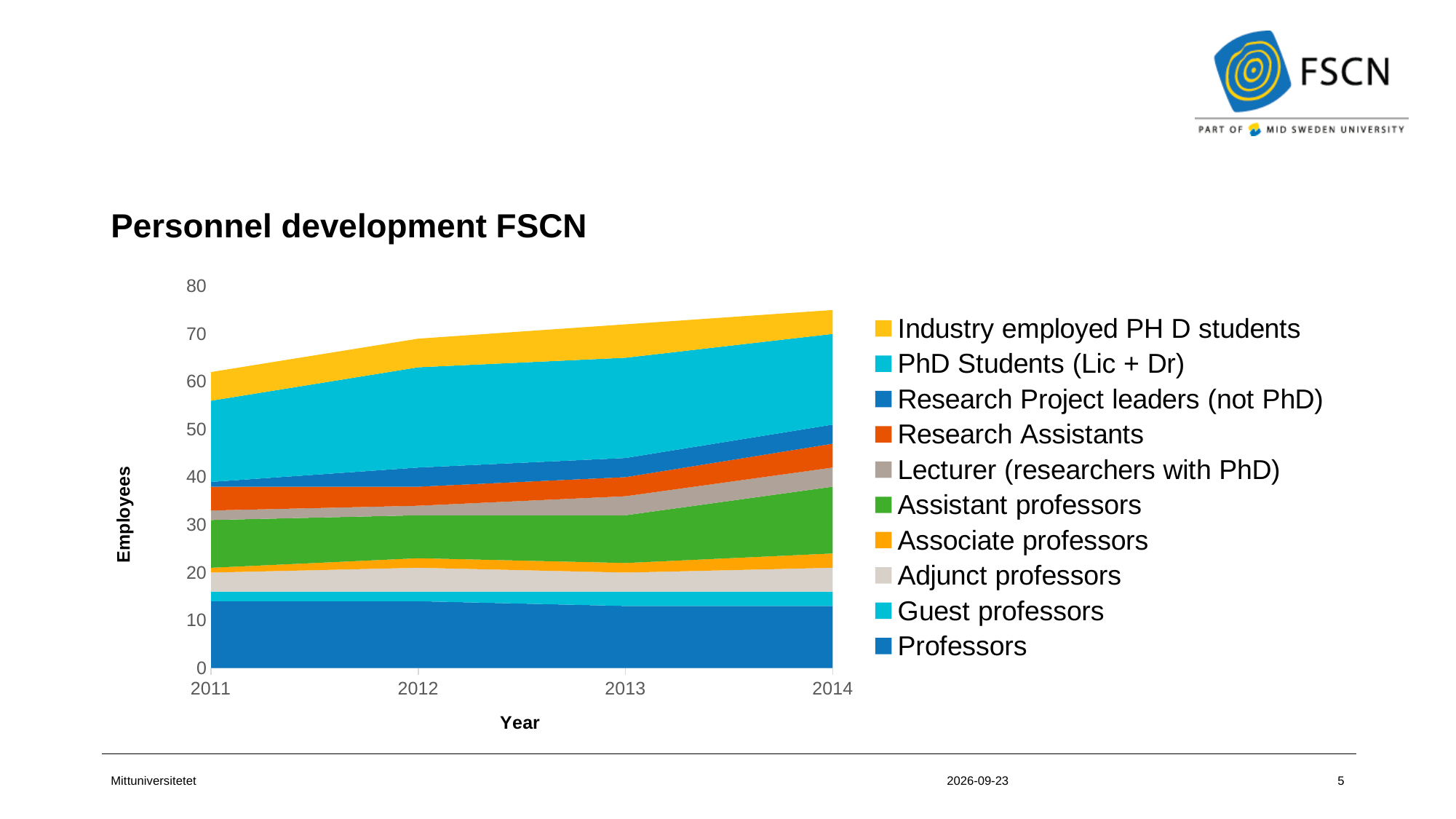
Is the total number of employees in 2014 greater or less than 70? greater In which year is the total number of employees highest? 2014 Is the number of Professors in 2011 greater or less than 20? less What kind of chart is shown on the slide? Stacked area chart In which year is the total number of employees lowest? 2011 What is the title of the chart? Personnel development FSCN Does the total number of employees rise or fall from 2011 to 2014? Rise Is the total number of employees in 2013 greater or less than 60? greater How many series does the legend list? 10 What is the label of the vertical axis? Employees How many years are shown on the x axis? 4